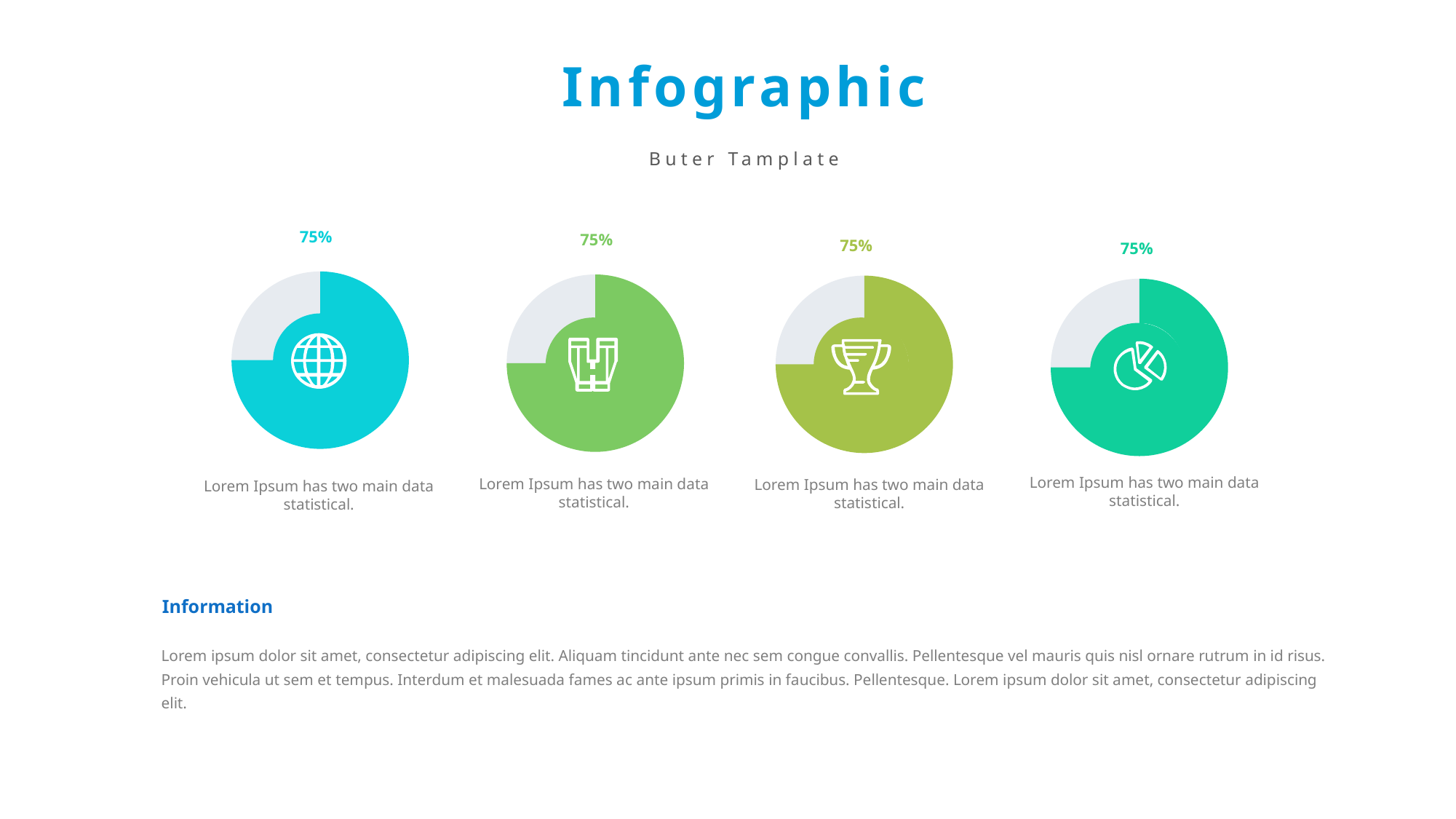
What is the main title of the slide above the pie charts? Infographic Is the value shown for the third pie chart from the left greater or less than 100%? less In the rightmost pie chart, what share of the pie is filled with the coloured (green) slice? 75% How many pie charts are shown on the slide? 4 What percentage is shown above the second pie chart from the left (with the binoculars icon)? 75% What percentage is shown above the leftmost pie chart (with the globe icon)? 75% Is the value shown for the leftmost pie chart greater or less than 50%? greater What colour is the filled slice of the leftmost pie chart? Cyan What kind of chart is used for each of the four graphics on the slide? Pie chart What percentage is shown above the rightmost pie chart (with the pie icon)? 75% What percentage is shown above the third pie chart from the left (with the trophy icon)? 75% In the leftmost pie chart, what share of the pie is filled with the coloured (cyan) slice? 75%